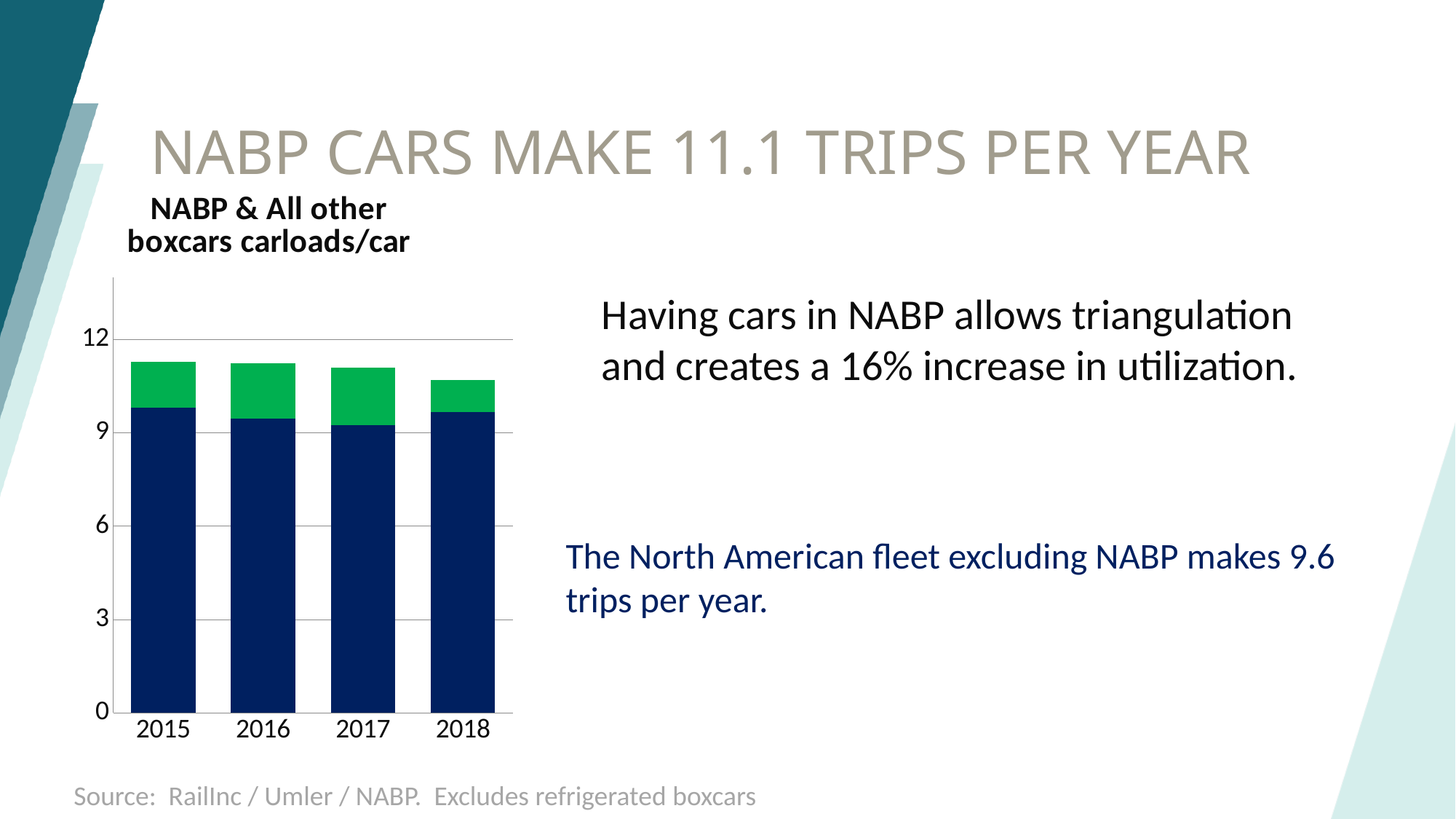
How many coloured segments make up each bar in the chart? 2 How many years are shown on the x axis of the chart? 4 Do the total bar heights rise or fall from 2015 to 2018? fall What kind of chart is shown on the slide? stacked bar chart Is the total bar height for 2018 greater or less than 12? less Is the dark blue segment for 2016 greater or less than 6? greater Which year has the lowest total bar height in the chart? 2018 Which is larger, the total bar for 2015 or the total bar for 2018? 2015 Is the total bar height for 2017 greater or less than 12? less Which year has the smallest green segment? 2018 What is the title of the chart? NABP & All other boxcars carloads/car